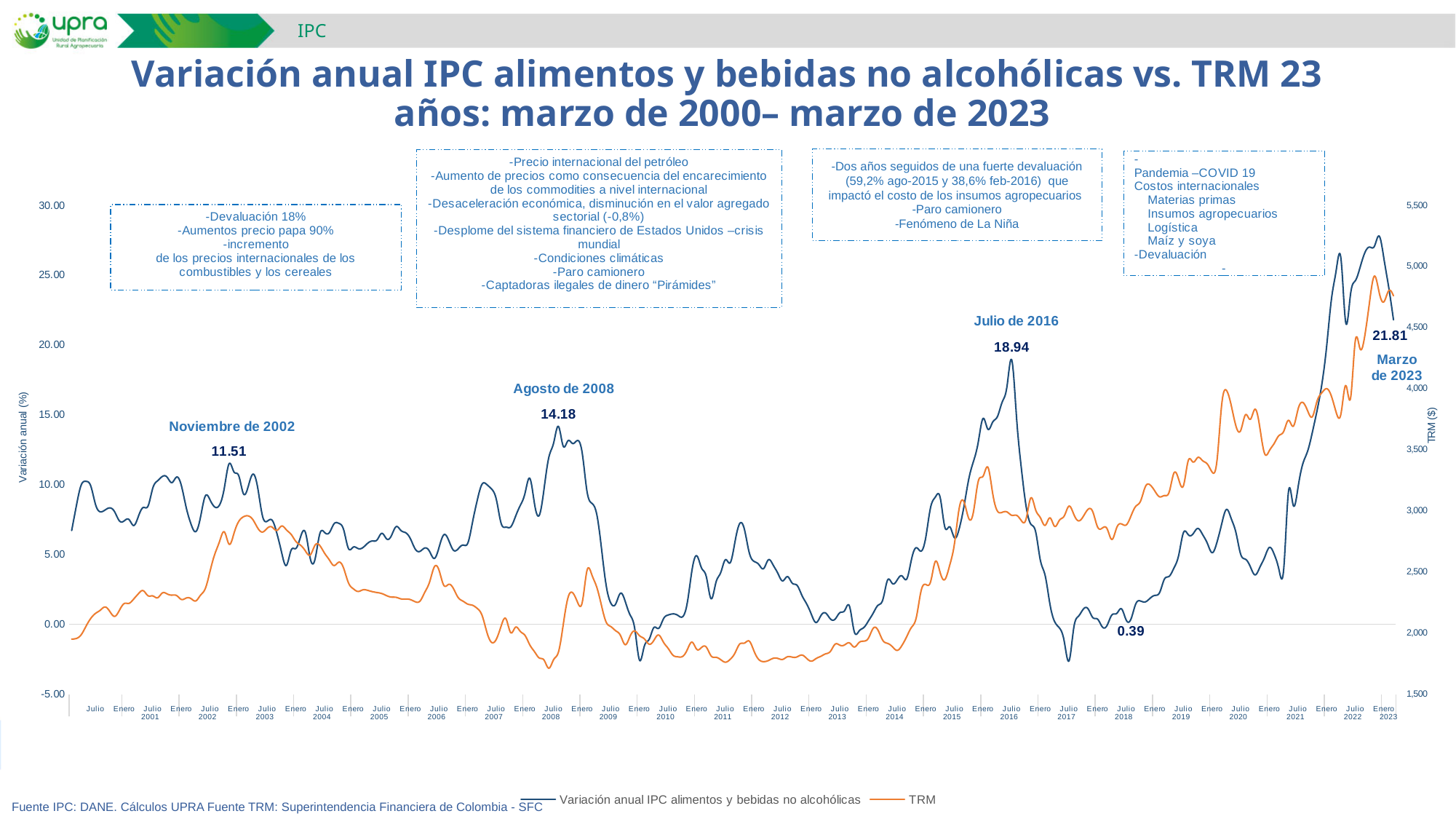
What is the labelled value of the annual IPC variation for Noviembre de 2002? 11.51 What is the lowest labelled value on the annual IPC variation line? 0.39 What is the label of the right-hand vertical axis? TRM ($) What is the labelled value of the annual IPC variation for Agosto de 2008? 14.18 What kind of chart is shown on the slide? line chart What is the labelled value of the annual IPC variation for Julio de 2016? 18.94 How many series does the legend list? 2 Which labelled IPC value is larger: Julio de 2016 or Agosto de 2008? Julio de 2016 What is the difference between the labelled IPC values for Marzo de 2023 and Julio de 2016? 2.87 Which of the labelled peaks of the annual IPC variation is the highest? Marzo de 2023 What is the labelled value of the annual IPC variation for Marzo de 2023? 21.81 Is the TRM value at the start of the series (Julio 2000) greater or less than 2,500? less